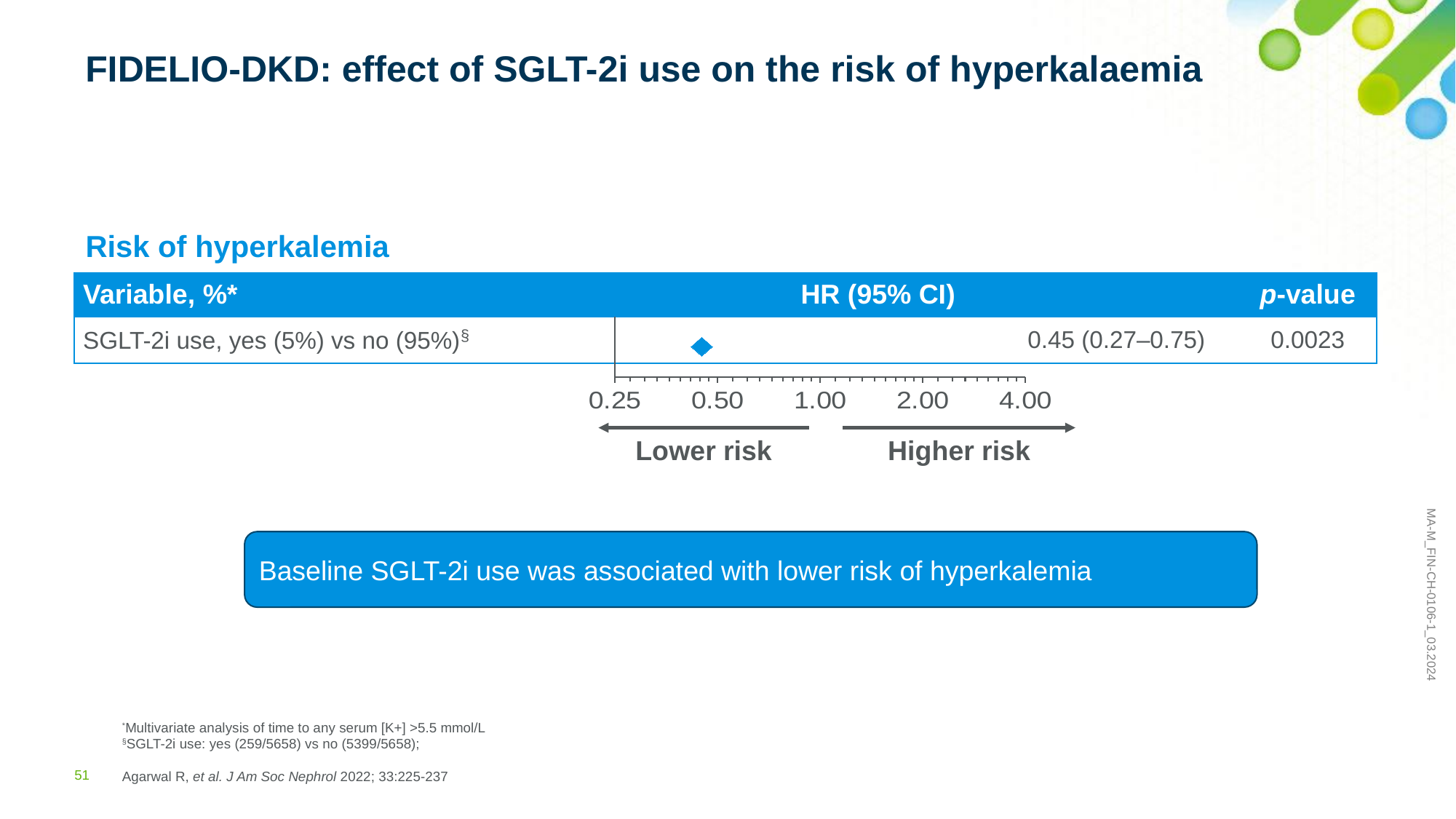
What is the 95% confidence interval for the hazard ratio of SGLT-2i use, yes vs no? 0.27–0.75 How many variables are plotted in the chart? 1 What is the title of the chart? Risk of hyperkalemia What kind of chart is shown on the slide? Forest plot Is the hazard ratio for SGLT-2i use, yes vs no greater or less than 0.50? less What is the lower bound of the 95% CI for SGLT-2i use, yes vs no? 0.27 What is the p-value shown for SGLT-2i use, yes vs no? 0.0023 What is the hazard ratio (HR) shown for SGLT-2i use, yes vs no? 0.45 What is the upper bound of the 95% CI for SGLT-2i use, yes vs no? 0.75 How many labelled tick values are shown on the hazard ratio axis? 5 Is the hazard ratio for SGLT-2i use, yes vs no greater or less than 1.00? less What does the arrow pointing left below the axis indicate? Lower risk